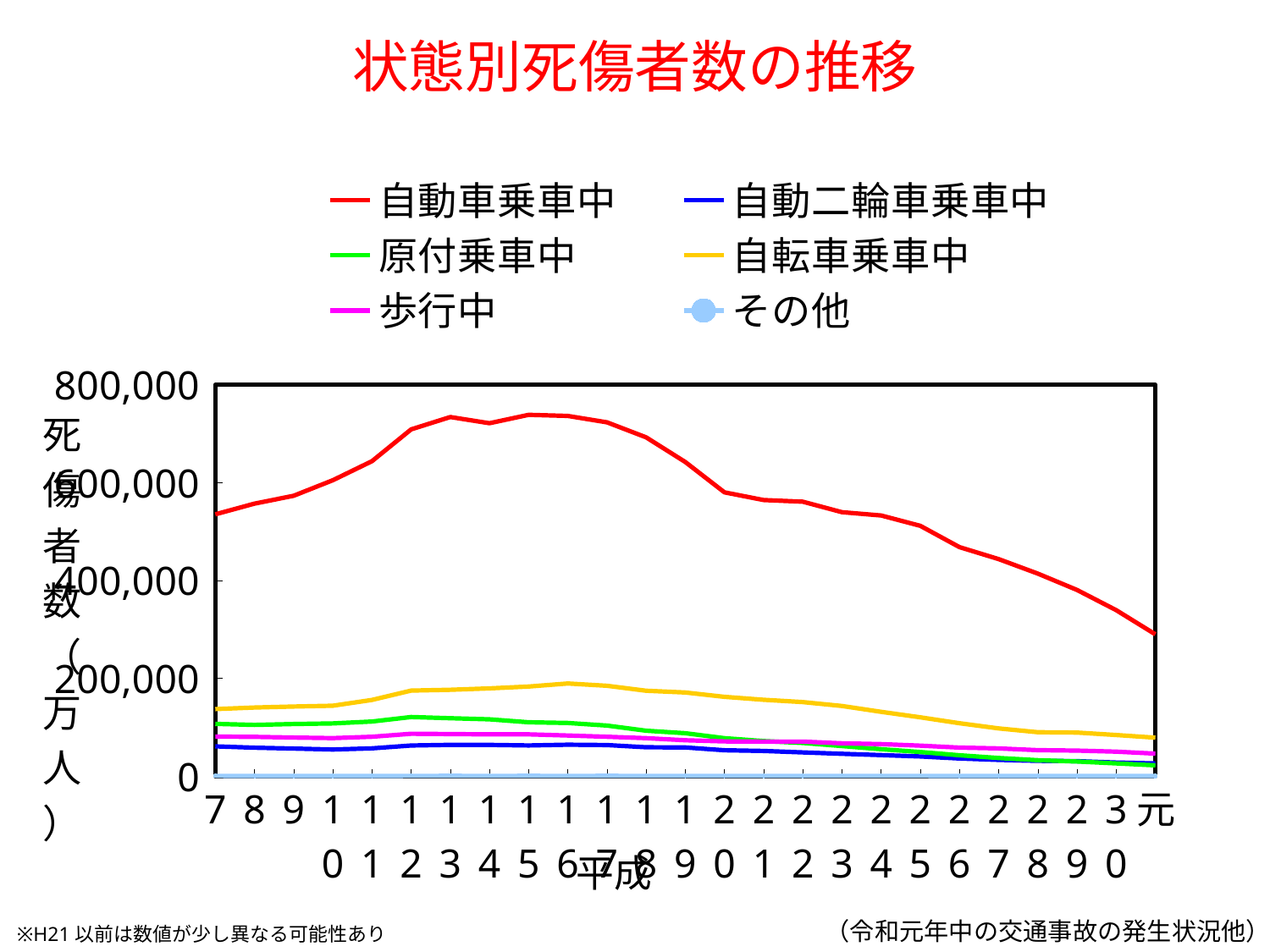
How many years (points) are plotted along the x axis? 25 Is the value for 自動車乗車中 in 平成7 greater or less than 400,000? greater Is the peak value of 自動車乗車中 greater or less than 600,000? greater Does the value for 自動車乗車中 rise or fall from 平成16 to 令和元? fall Which series has the lowest values throughout the chart? その他 Is the highest value of 自転車乗車中 greater or less than 200,000? less How many series does the legend list? 6 What is the title of the chart? 状態別死傷者数の推移 In 平成7, which is larger: 自転車乗車中 or 原付乗車中? 自転車乗車中 What kind of chart is shown on the slide? line chart Which series has the highest values throughout the chart? 自動車乗車中